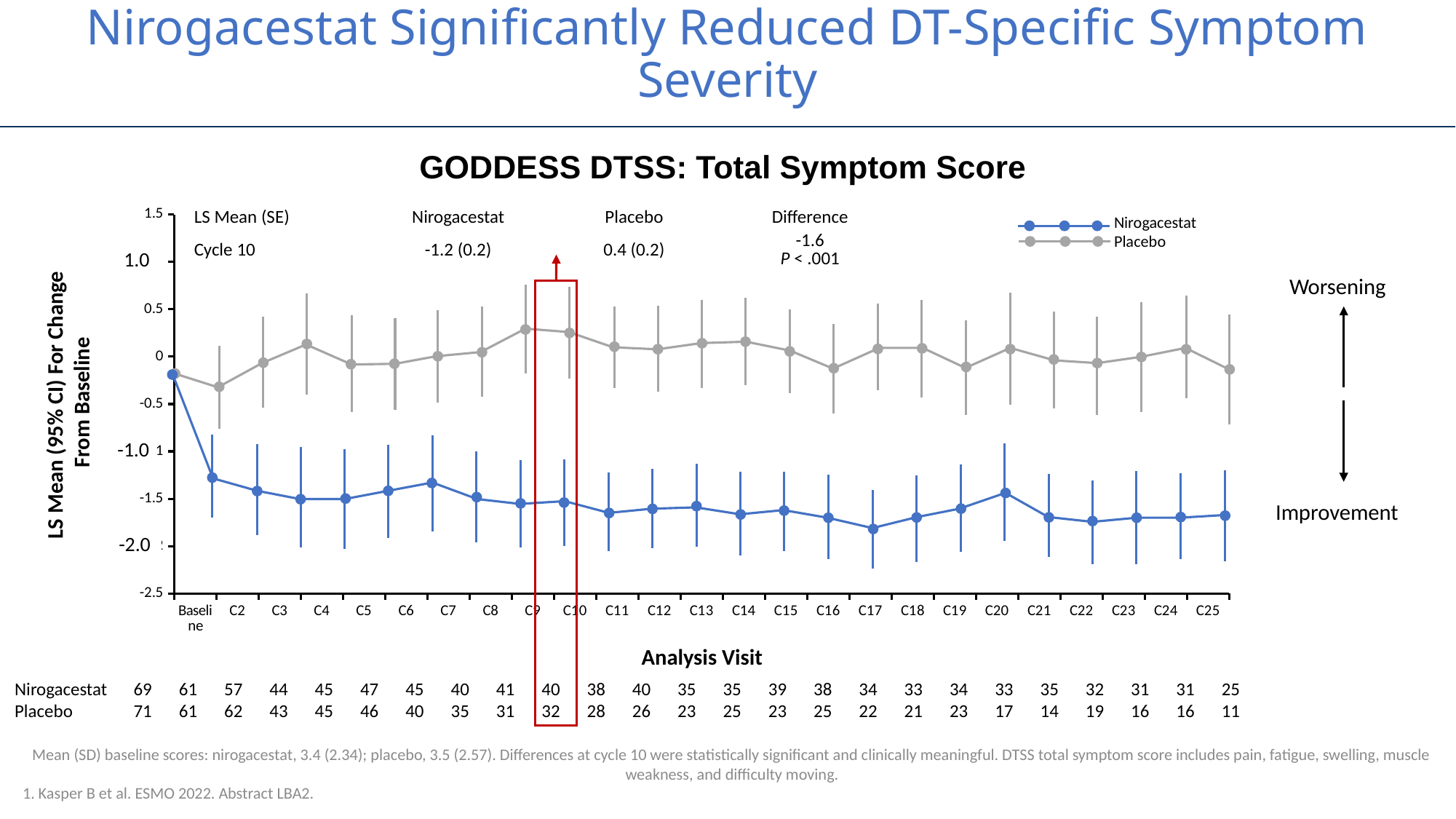
How many analysis visits are shown along the x axis (including Baseline)? 25 What is the LS Mean (SE) at Cycle 10 for Nirogacestat, as printed on the chart? -1.2 (0.2) Is the Placebo value at C9 greater or less than 0? greater What is the LS Mean (SE) at Cycle 10 for Placebo, as printed on the chart? 0.4 (0.2) What kind of chart is shown on the slide? Line chart Is the Nirogacestat value at C17 greater or less than -1.5? less According to the table below the chart, what is the difference between the Nirogacestat and Placebo patient counts at C10? 8 At C10, which series has the higher LS Mean value, Nirogacestat or Placebo? Placebo How many series does the legend list? 2 What is the printed difference between Nirogacestat and Placebo at Cycle 10? -1.6 Does the Nirogacestat line rise or fall from Baseline to C2? Fall According to the table below the chart, how many Placebo patients are listed at C25? 11